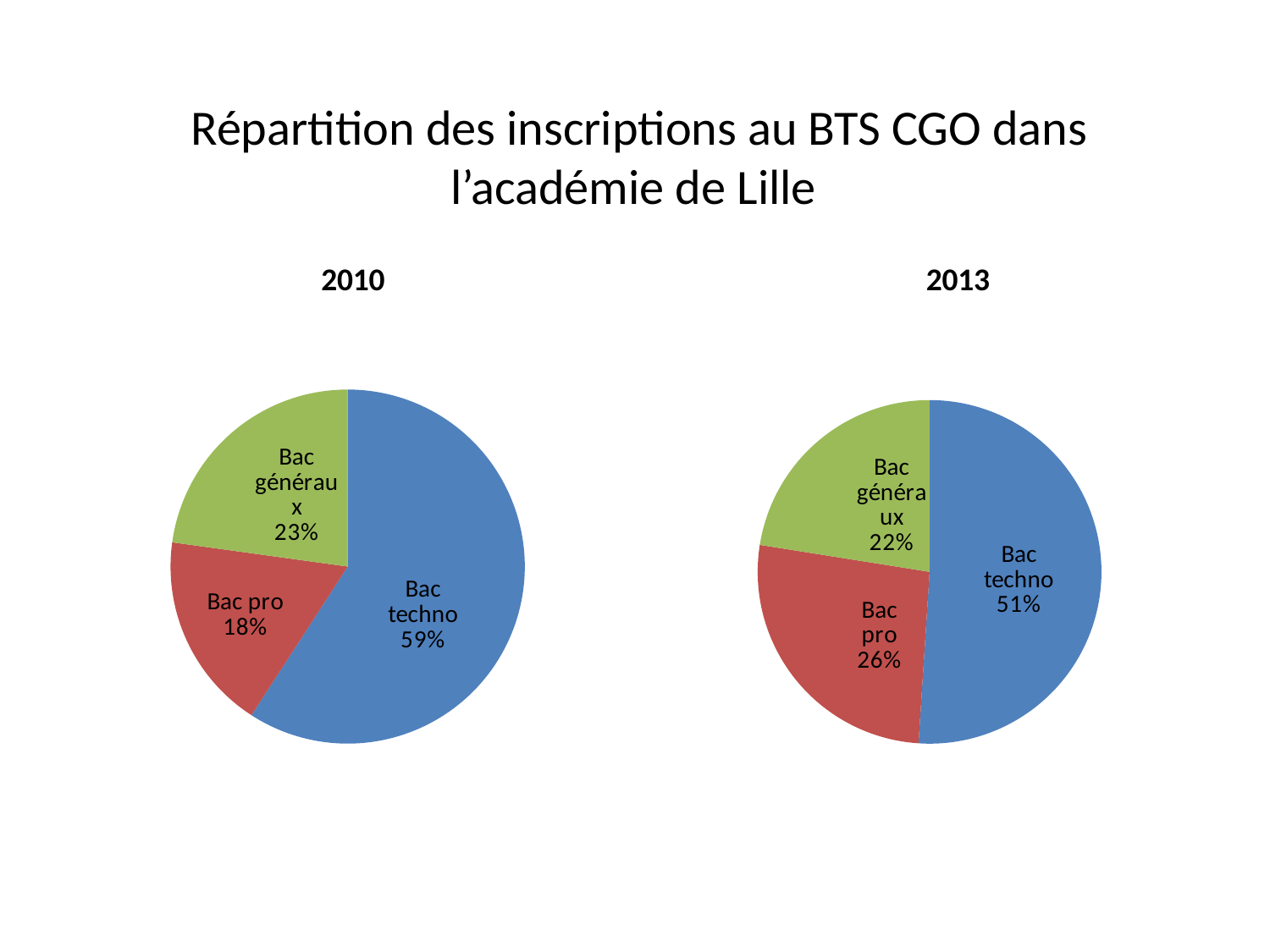
In the 2010 pie chart, which category has the smallest share? Bac pro In the 2013 pie chart, what share of inscriptions is Bac pro? 26% In the 2013 pie chart, what share of inscriptions is Bac généraux? 22% What colour is the Bac techno slice in both pie charts? Blue Is the Bac pro share larger in the 2010 chart or the 2013 chart? 2013 How many categories does the 2013 pie chart show? 3 What type of chart is used for the 2010 data? Pie chart In the 2010 pie chart, which category has the largest share? Bac techno What is the difference between the Bac techno share in 2010 and in 2013? 8 percentage points In the 2010 pie chart, what share of inscriptions is Bac techno? 59% In the 2013 pie chart, which category has the smallest share? Bac généraux In the 2010 pie chart, what share of inscriptions is Bac généraux? 23%